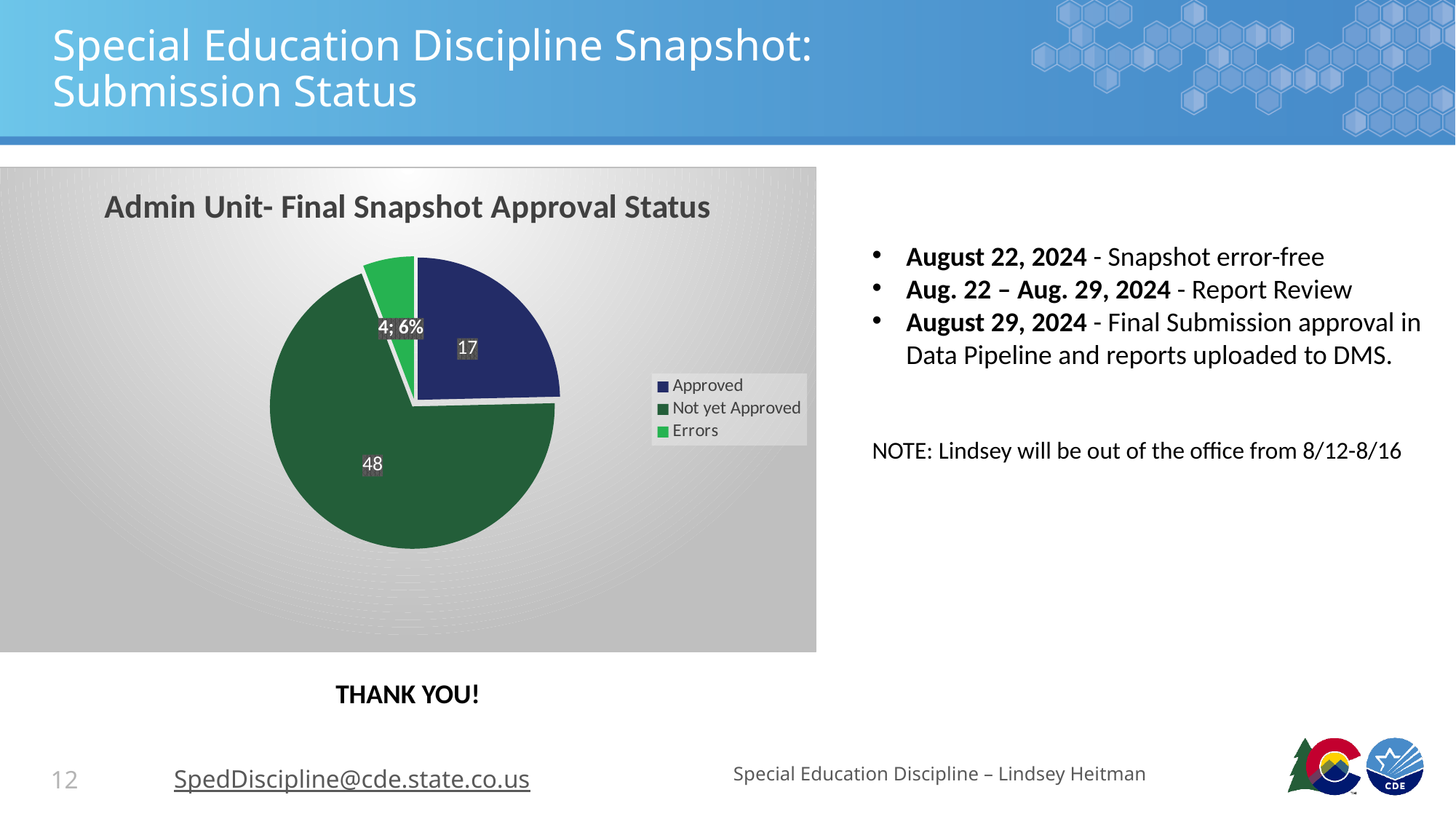
What is the title of the chart? Admin Unit- Final Snapshot Approval Status How many admin units are in the Errors category? 4 How many categories does the legend list? 3 How many admin units are in the Approved category? 17 What is the difference between the Not yet Approved and Approved counts? 31 How many admin units are in the Not yet Approved category? 48 What percentage of the pie does the Errors slice represent? 6% What type of chart is shown on the slide? pie chart What is the total number of admin units across all three slices? 69 Which is larger, the Approved count or the Errors count? Approved Which category has the smallest slice of the pie? Errors Which category has the largest slice of the pie? Not yet Approved